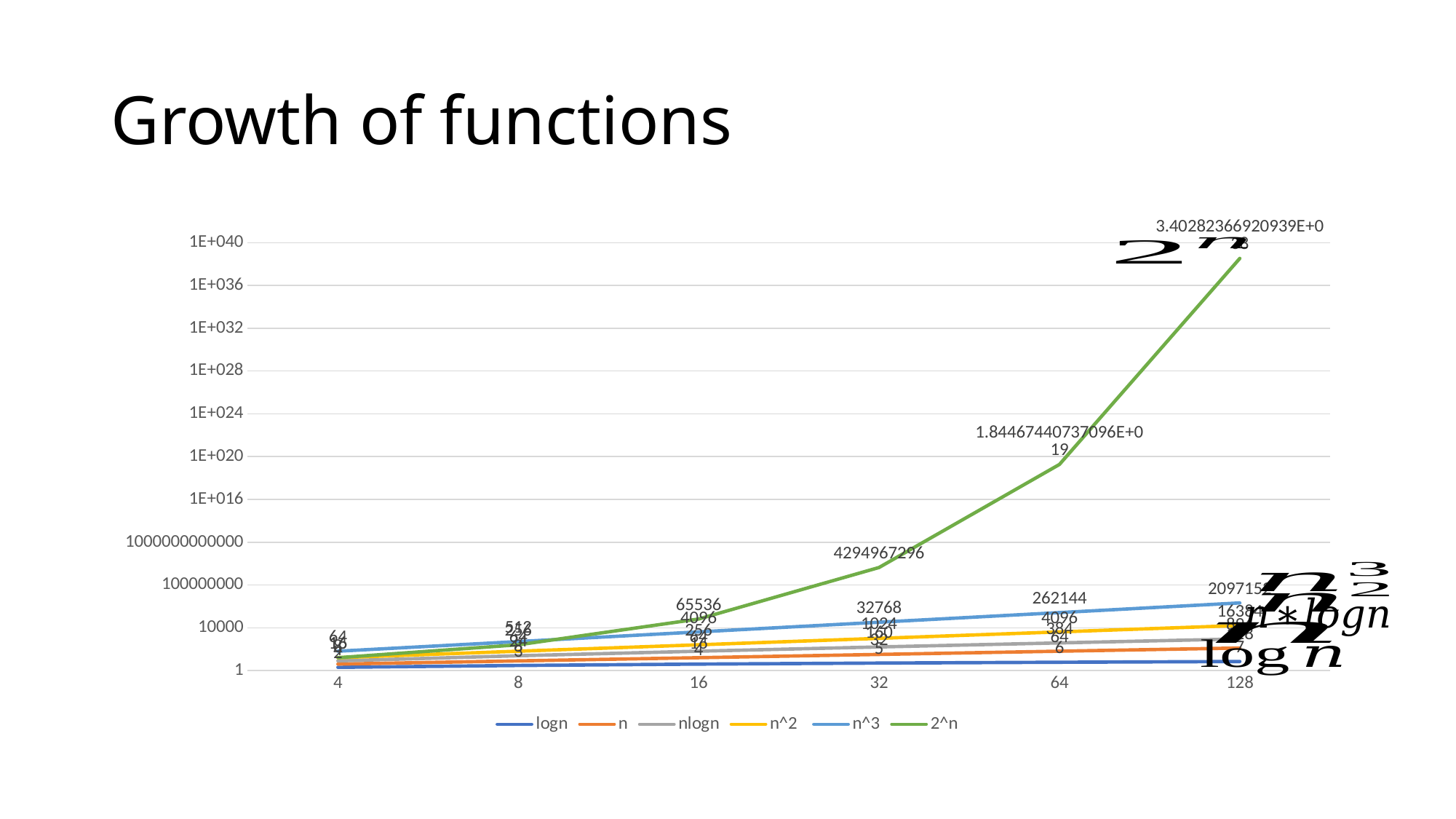
What is the value of the 2^n series at x = 16? 65536 How many x-axis categories are plotted? 6 What kind of chart is shown on the slide? line chart What is the value of the 2^n series at x = 32? 4294967296 What is the value of the nlogn series at x = 32? 160 What is the value of the n^2 series at x = 64? 4096 What is the value of the n^3 series at x = 64? 262144 Does the 2^n series rise or fall as x increases? rise How many series does the legend list? 6 Which series has the highest value at x = 128? 2^n At x = 64, which is larger: the n^3 value or the n^2 value? n^3 What is the value of the n^3 series at x = 32? 32768